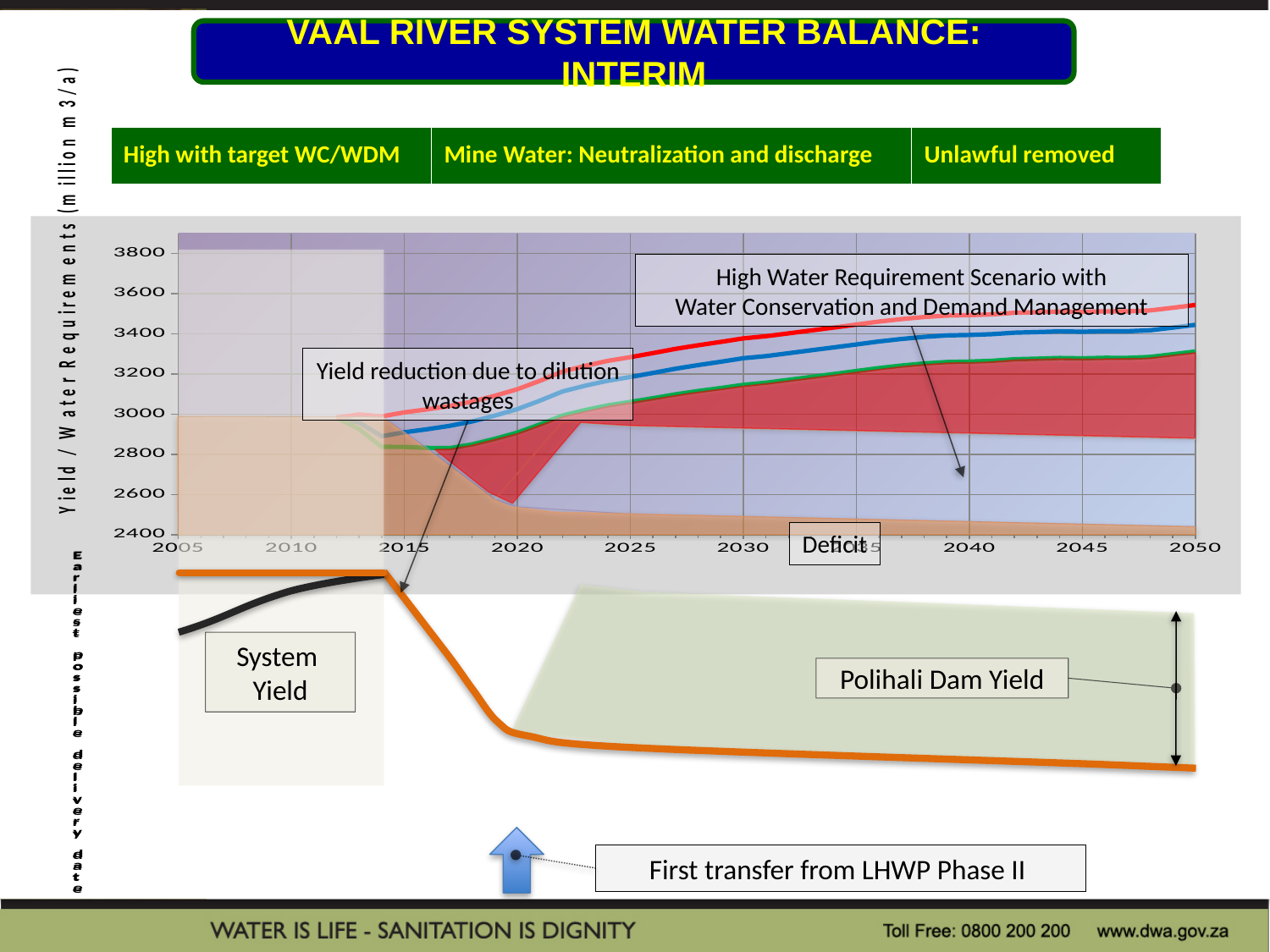
Does the red High Water Requirement Scenario line rise or fall between 2015 and 2050? rise What does the red shaded area between the water requirement lines and the yield line represent? Deficit Is the value of the red High Water Requirement Scenario line in 2050 greater or less than 3400? greater Does the orange system yield line rise or fall between 2015 and 2020? fall What kind of chart is shown on the slide? line chart Is the value of the blue line in 2050 greater or less than 3200? greater Is the value of the green line in 2050 greater or less than 3000? greater What is the highest value labelled on the y axis of the chart? 3800 How many year labels are shown on the x axis of the chart? 10